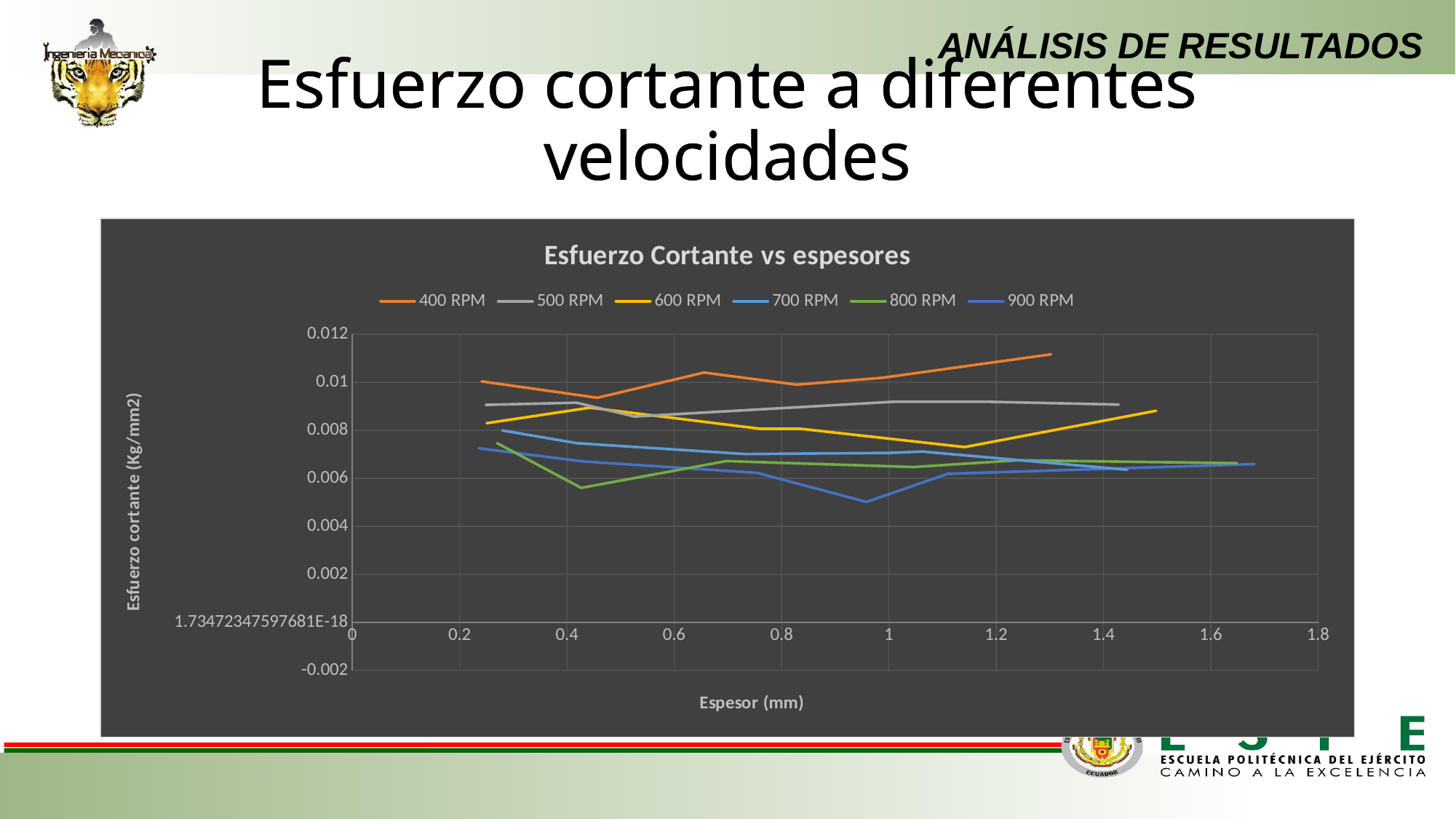
Is the highest value of the 400 RPM series greater or less than 0.01? greater Which series reaches the lowest value on the chart? 900 RPM Is the value of the 500 RPM series at an espesor of about 0.25 mm greater or less than 0.008? greater How many series does the legend of the chart list? 6 What is the label of the x axis of the chart? Espesor (mm) Which series has larger values, 400 RPM or 900 RPM? 400 RPM Is the lowest value of the 800 RPM series greater or less than 0.006? less What kind of chart is shown on the slide? line chart Do the values of the 700 RPM series rise or fall as espesor increases? fall What is the title of the chart? Esfuerzo Cortante vs espesores Which series has the highest values across the chart? 400 RPM